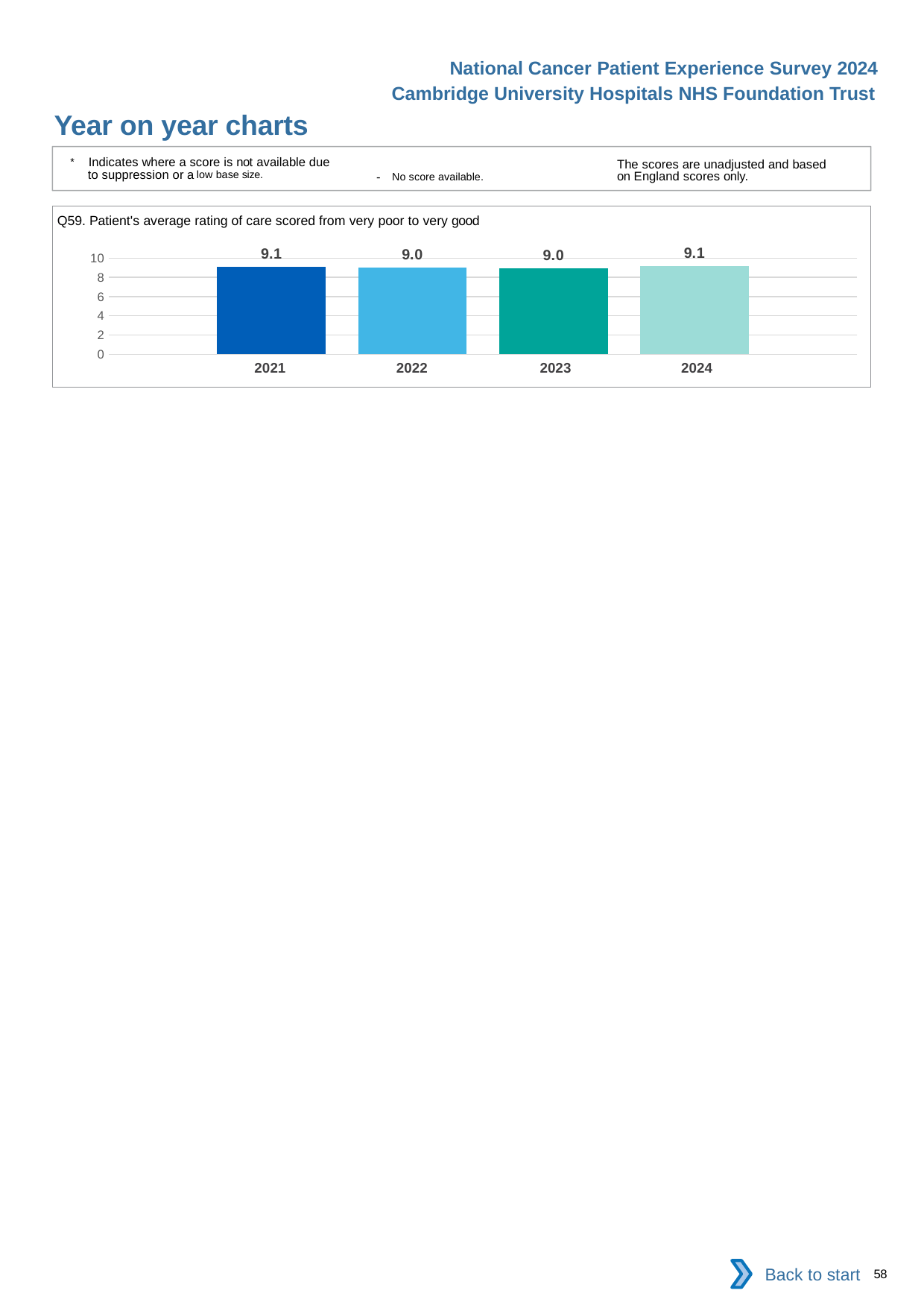
What is the difference between the 2021 and 2022 values in the Q59 chart? 0.1 Which is larger in the Q59 chart, the value for 2021 or the value for 2022? 2021 What is the title of the chart on the slide? Q59. Patient's average rating of care scored from very poor to very good What is the highest value shown on the y axis of the Q59 chart? 10 What kind of chart is used for Q59? bar chart What is the value for 2021 in the Q59 chart? 9.1 Is the value for 2023 in the Q59 chart greater or less than 8? greater What is the difference between the 2024 and 2023 values in the Q59 chart? 0.1 How many years are shown on the x axis of the Q59 chart? 4 What is the value for 2024 in the Q59 chart? 9.1 What is the value for 2022 in the Q59 chart? 9.0 What is the value for 2023 in the Q59 chart? 9.0